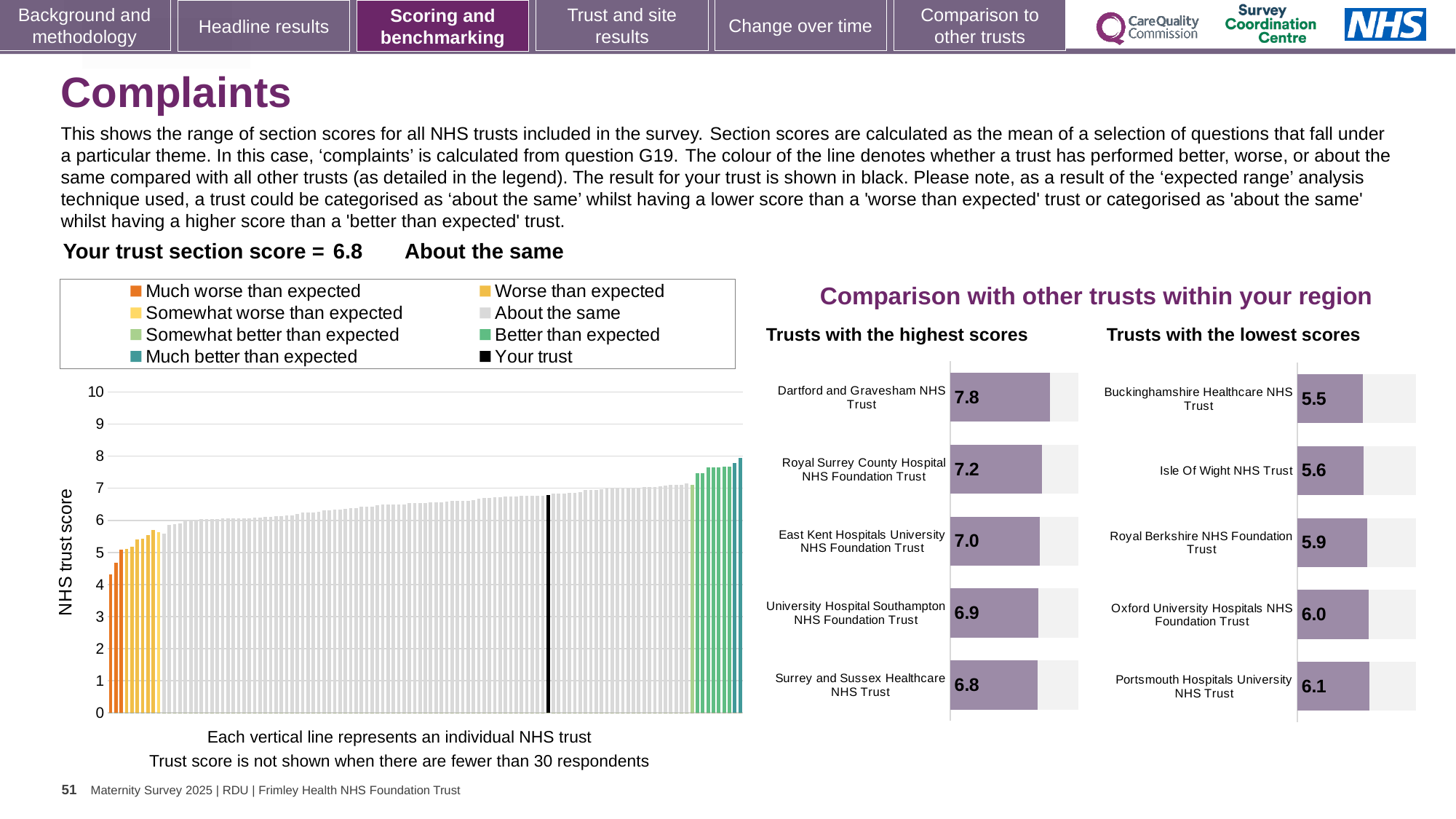
In the 'Trusts with the lowest scores' chart, which trust has the lowest score? Buckinghamshire Healthcare NHS Trust In the 'Trusts with the highest scores' chart, what is the score for East Kent Hospitals University NHS Foundation Trust? 7.0 In the 'Trusts with the lowest scores' chart, which has the higher score: Royal Berkshire NHS Foundation Trust or Oxford University Hospitals NHS Foundation Trust? Oxford University Hospitals NHS Foundation Trust In the NHS trust score chart, do the bar values rise or fall from left to right? rise In the NHS trust score chart, is the value of the lowest bar greater or less than 5? less How many trusts are listed in the 'Trusts with the highest scores' chart? 5 In the 'Trusts with the lowest scores' chart, what is the score for Isle Of Wight NHS Trust? 5.6 In the 'Trusts with the lowest scores' chart, what is the difference between the scores of Portsmouth Hospitals University NHS Trust and Buckinghamshire Healthcare NHS Trust? 0.6 In the 'Trusts with the highest scores' chart, which trust has the highest score? Dartford and Gravesham NHS Trust In the 'Trusts with the highest scores' chart, what is the difference between the scores of Dartford and Gravesham NHS Trust and Surrey and Sussex Healthcare NHS Trust? 1.0 How many entries does the legend of the NHS trust score chart list? 8 In the 'Trusts with the highest scores' chart, what is the score for Dartford and Gravesham NHS Trust? 7.8